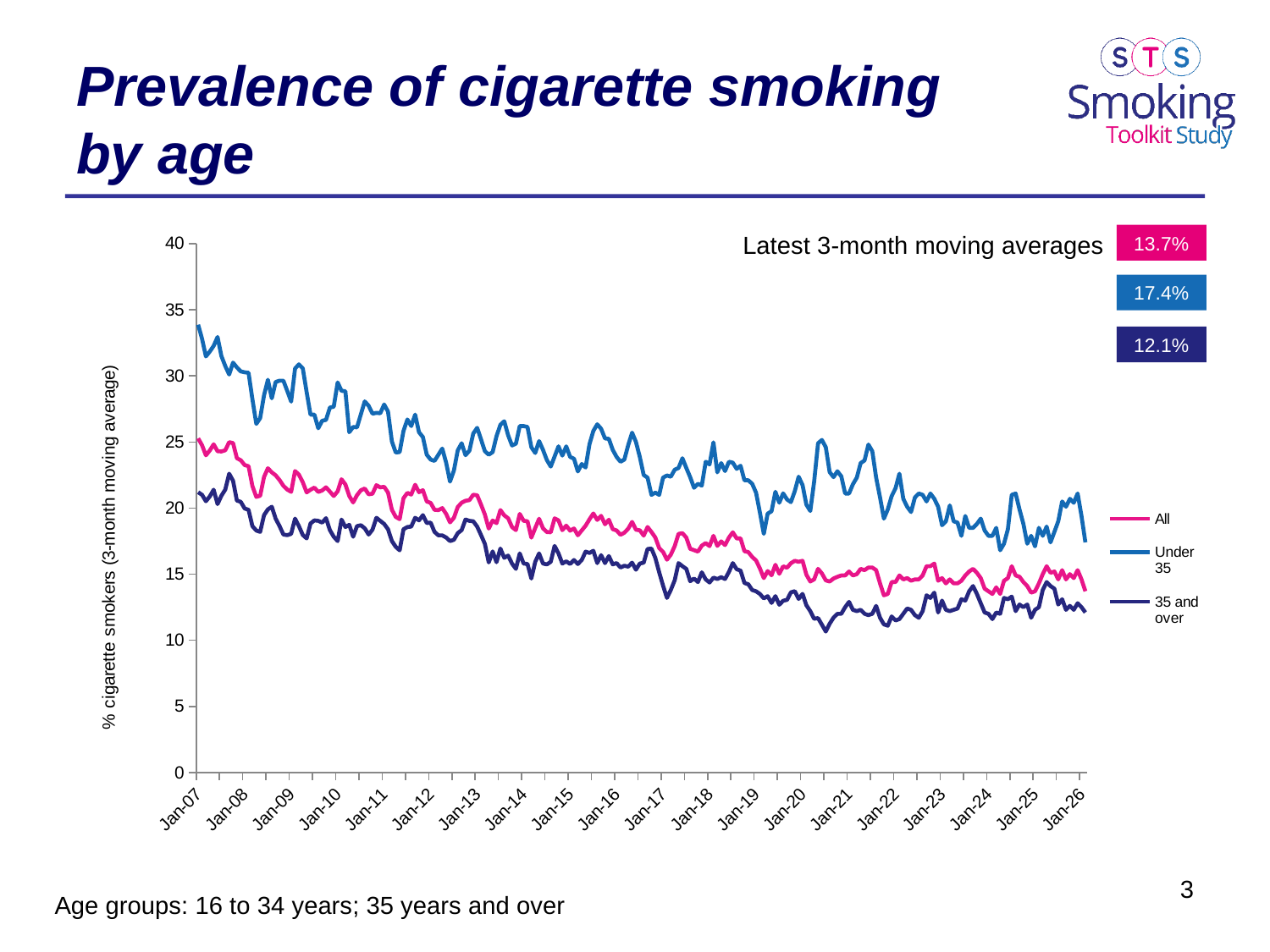
Do the smoking prevalence values generally rise or fall from Jan-07 to Jan-26? fall Is the value for 35 and over at Jan-07 greater or less than 25? less What is the latest 3-month moving average for the Under 35 group? 17.4% How many series does the legend list? 3 What kind of chart is shown on the slide? line chart Which age group has the lowest latest 3-month moving average? 35 and over What is the latest 3-month moving average for the All group? 13.7% What is the label on the vertical axis? % cigarette smokers (3-month moving average) Is the value for Under 35 at Jan-07 greater or less than 30? greater What is the difference between the latest 3-month moving averages for Under 35 and 35 and over? 5.3 percentage points What is the latest 3-month moving average for the 35 and over group? 12.1% Which age group has the highest latest 3-month moving average? Under 35